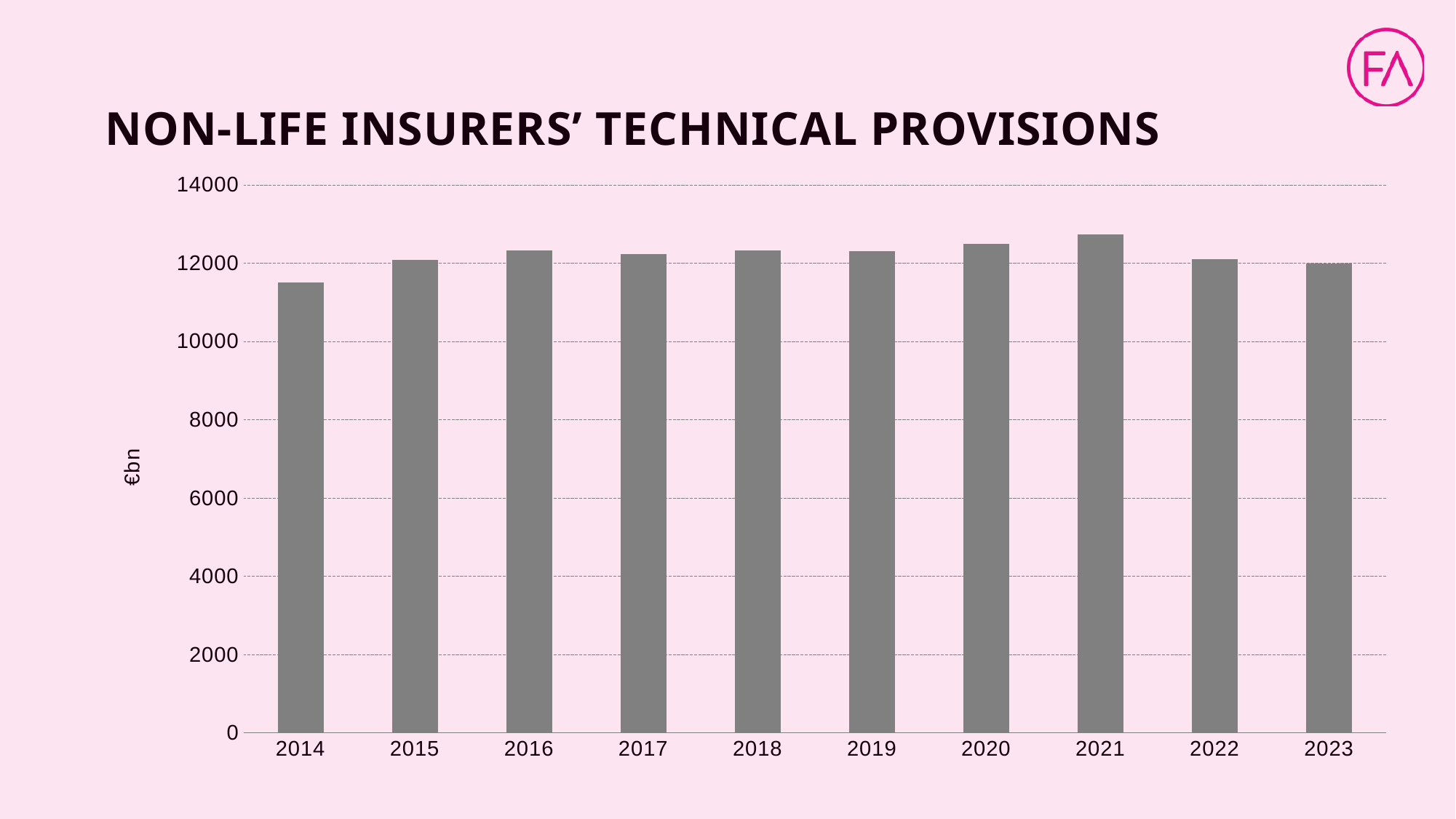
How many years are shown on the x axis? 10 Do the values rise or fall from 2021 to 2023? fall What kind of chart is shown on the slide? bar chart Is the value for 2020 greater or less than 12000? greater Which is larger, the value for 2014 or the value for 2015? 2015 Is the value for 2014 greater or less than 12000? less Which is larger, the value for 2021 or the value for 2022? 2021 What is the title of the chart? NON-LIFE INSURERS' TECHNICAL PROVISIONS Which year has the highest technical provisions? 2021 Which year has the lowest technical provisions? 2014 What unit is shown on the vertical axis label? €bn Is the value for 2021 greater or less than 12000? greater